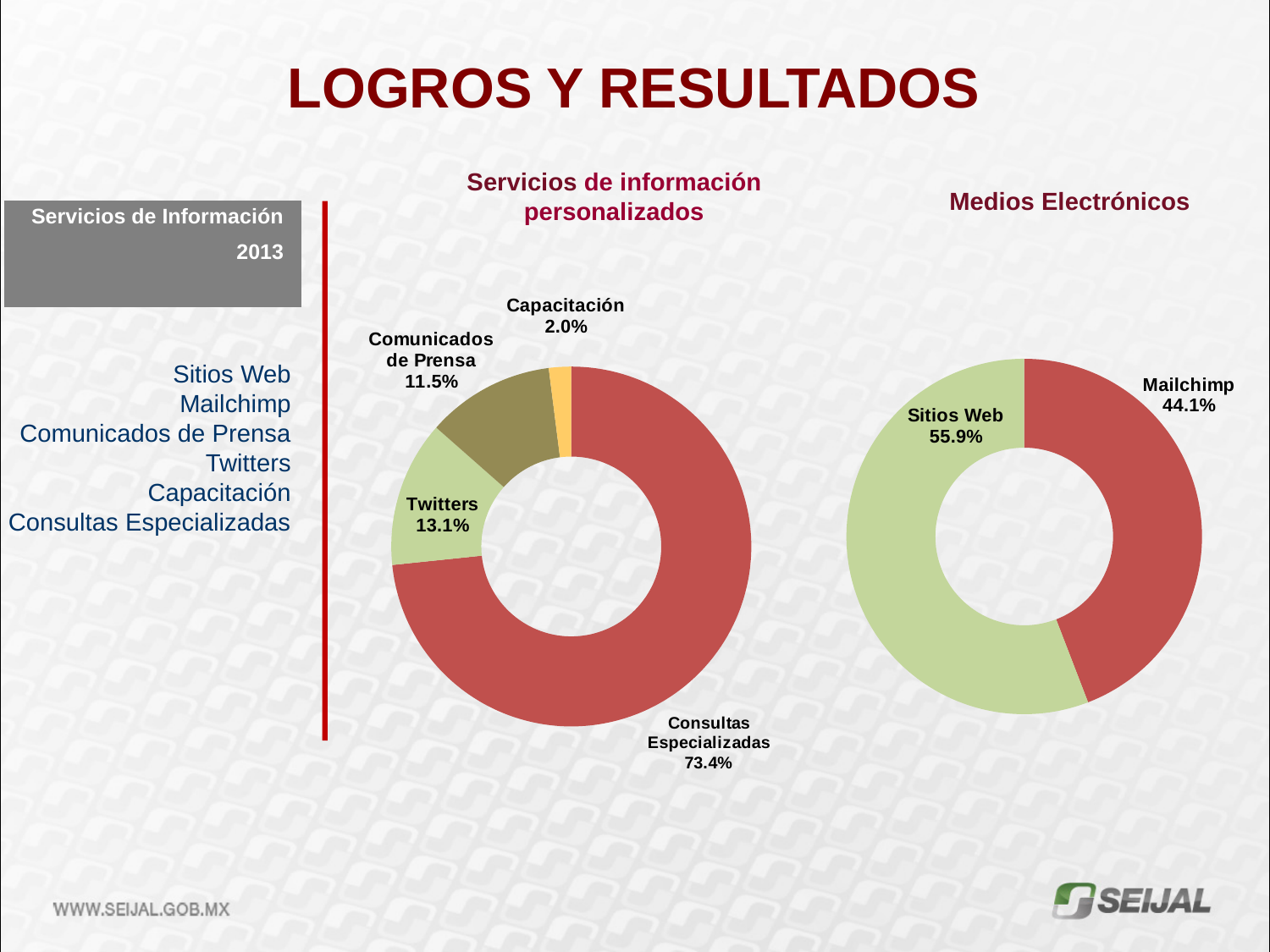
In the 'Medios Electrónicos' chart, which is larger, Sitios Web or Mailchimp? Sitios Web In the 'Servicios de información personalizados' chart, what share does Consultas Especializadas have? 73.4% In the 'Medios Electrónicos' chart, what is the value for Sitios Web? 55.9% In the 'Servicios de información personalizados' chart, how many categories are shown? 4 In the 'Medios Electrónicos' chart, what is the difference between Sitios Web and Mailchimp? 11.8% In the 'Servicios de información personalizados' chart, which category has the largest share? Consultas Especializadas What type of chart is the 'Medios Electrónicos' chart? Doughnut chart In the 'Servicios de información personalizados' chart, what is the value for Comunicados de Prensa? 11.5% In the 'Servicios de información personalizados' chart, what is the value for Twitters? 13.1% In the 'Servicios de información personalizados' chart, what is the difference between Twitters and Comunicados de Prensa? 1.6% In the 'Medios Electrónicos' chart, what is the value for Mailchimp? 44.1% In the 'Servicios de información personalizados' chart, which category has the smallest share? Capacitación